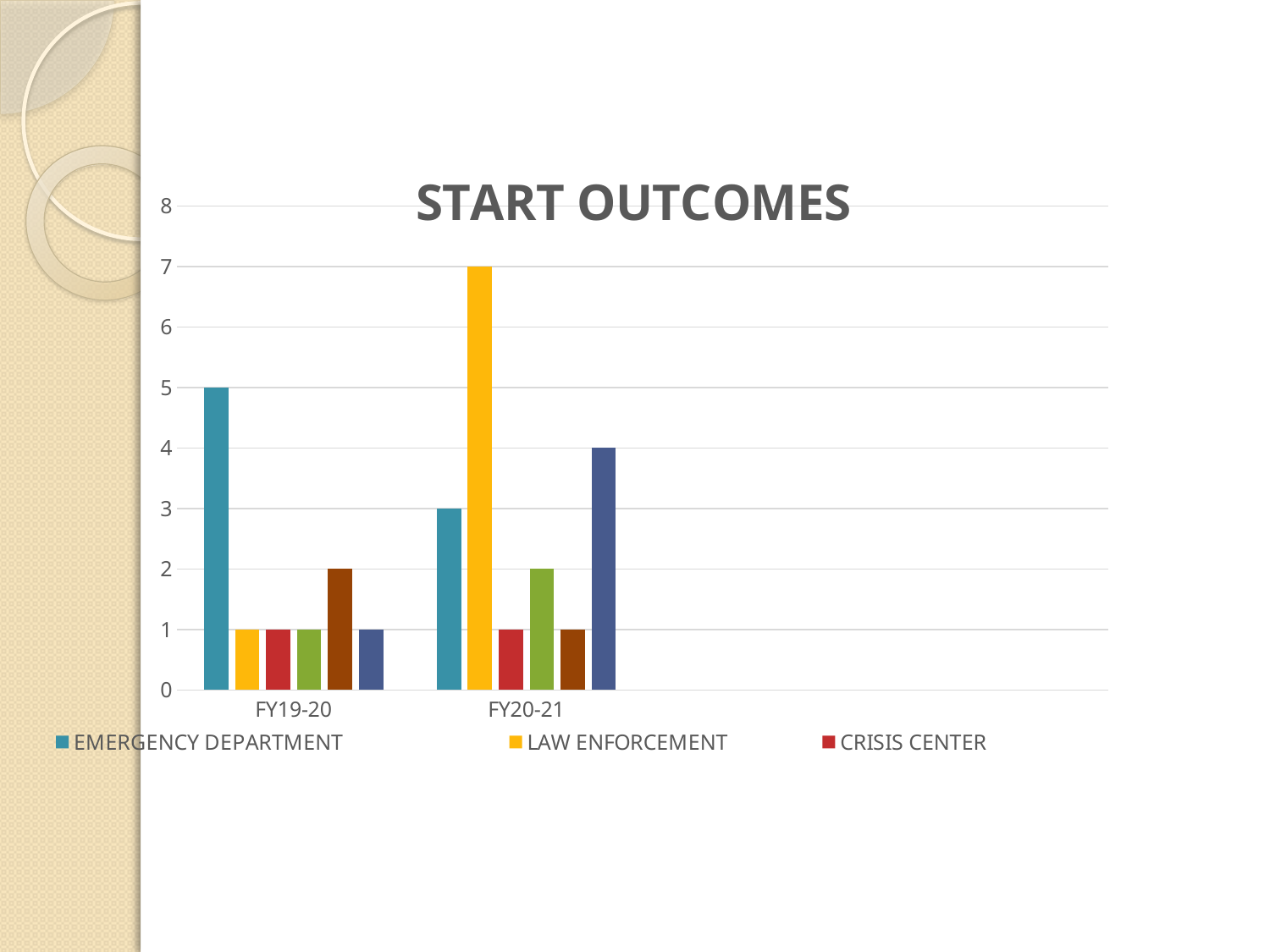
What is the value for CRISIS CENTER in FY20-21? 1 Which legend series has the tallest bar in FY20-21? LAW ENFORCEMENT What kind of chart is shown on the slide? bar chart What is the value for LAW ENFORCEMENT in FY19-20? 1 What is the value for EMERGENCY DEPARTMENT in FY20-21? 3 How many fiscal-year categories are shown on the x axis? 2 What is the value for LAW ENFORCEMENT in FY20-21? 7 What is the value for EMERGENCY DEPARTMENT in FY19-20? 5 By how much did the LAW ENFORCEMENT value increase from FY19-20 to FY20-21? 6 How many series does the legend list? 3 Which fiscal year has the higher value for EMERGENCY DEPARTMENT, FY19-20 or FY20-21? FY19-20 What is the title of the chart? START OUTCOMES